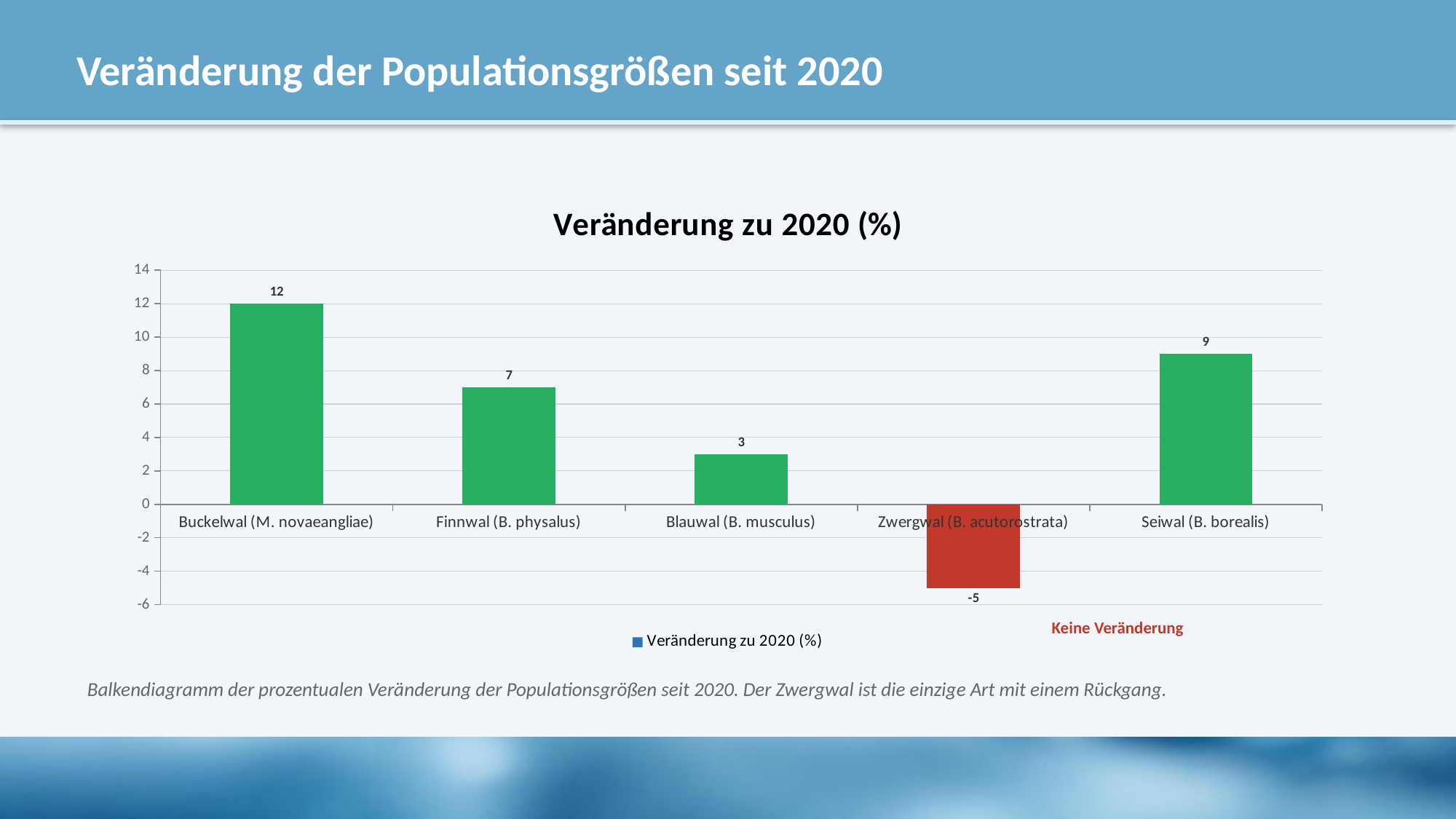
What is the title of the chart? Veränderung zu 2020 (%) What is the value for Buckelwal (M. novaeangliae)? 12 How many series does the legend list? 1 What is the value for Seiwal (B. borealis)? 9 What is the value for Zwergwal (B. acutorostrata)? -5 Which category has the lowest value? Zwergwal (B. acutorostrata) How many categories are shown on the x axis? 5 Which is larger, the value for Finnwal (B. physalus) or the value for Seiwal (B. borealis)? Seiwal (B. borealis) What is the difference between the values for Buckelwal (M. novaeangliae) and Finnwal (B. physalus)? 5 Is the value for Blauwal (B. musculus) greater or less than 4? less What kind of chart is shown? bar chart Which category has the highest value? Buckelwal (M. novaeangliae)